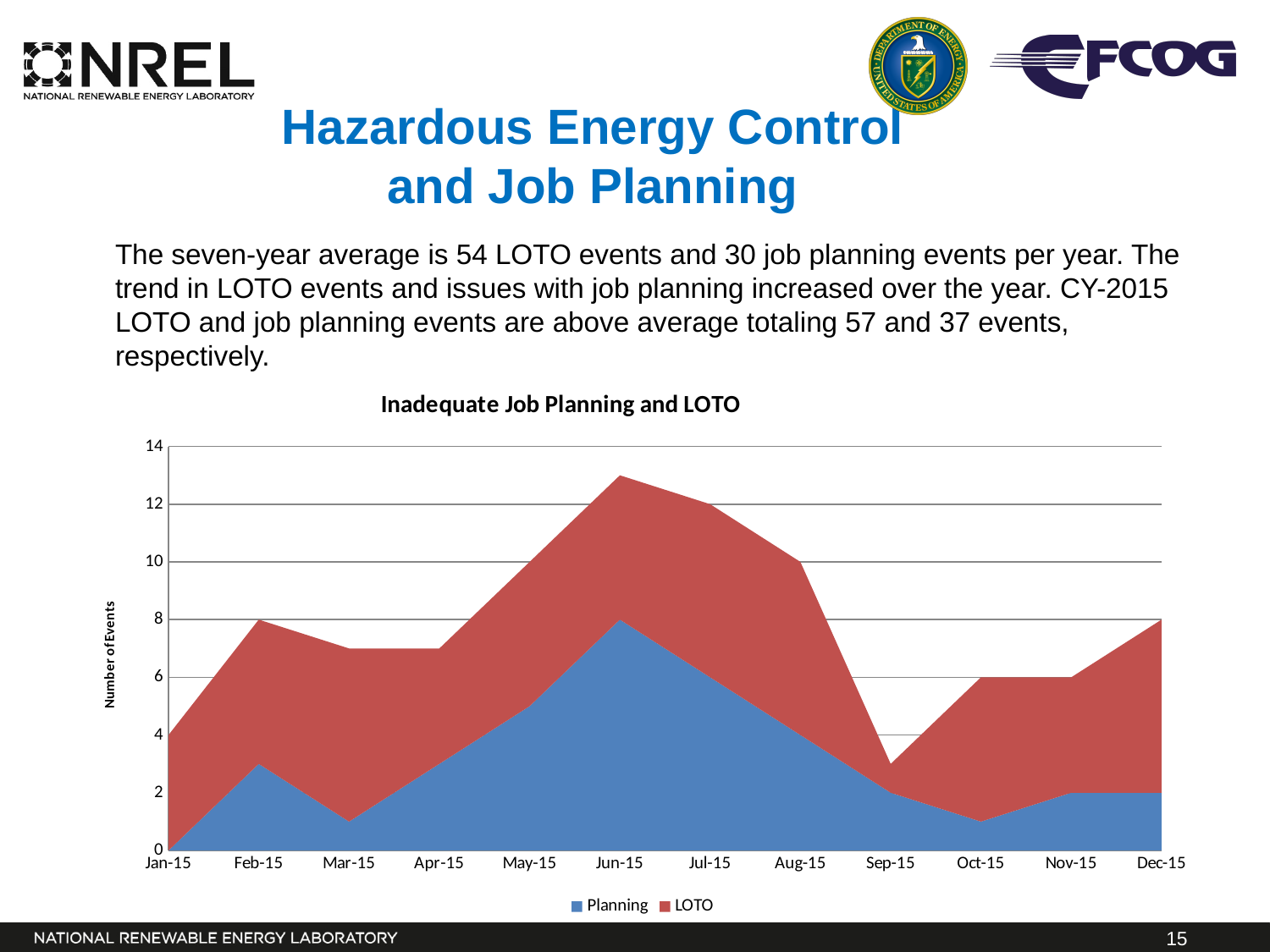
Which month has the highest combined total of Planning and LOTO events? Jun-15 How many series does the chart legend list? 2 In which month does the Planning series reach its highest value? Jun-15 Is the combined Planning and LOTO total for Jun-15 greater or less than 12? greater What is the Planning value for Jan-15? 0 What is the title of the chart? Inadequate Job Planning and LOTO Is the combined Planning and LOTO total for Sep-15 greater or less than 4? less How many months are shown along the x axis of the chart? 12 Does the combined total of events rise or fall from Jun-15 to Sep-15? Fall What is the Planning value for Jun-15? 8 What kind of chart is shown on the slide? Area chart In which month is the Planning series at its lowest value? Jan-15